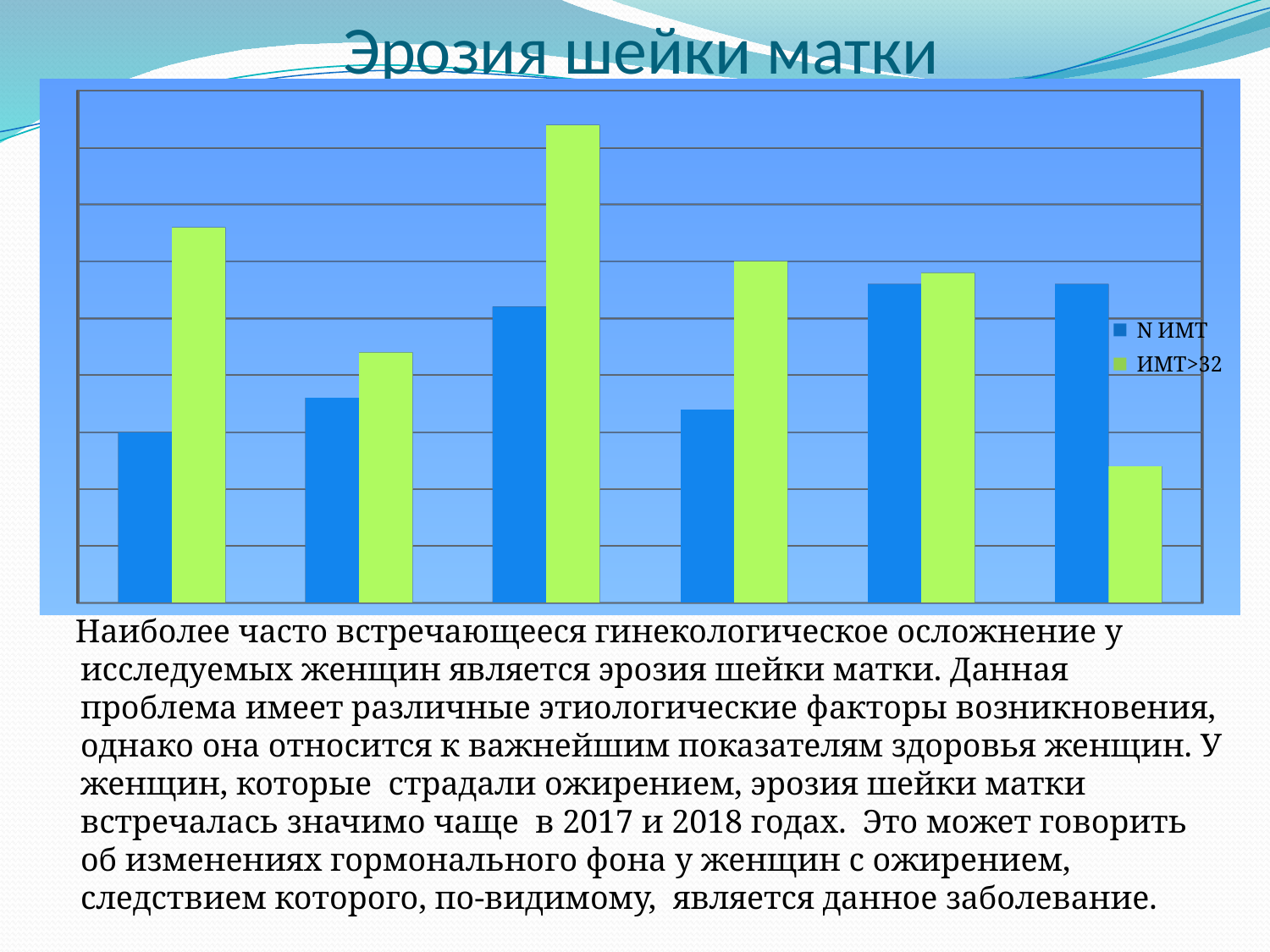
Which group of bars, counting from the left, has the tallest ИМТ>32 bar? the third In the rightmost group of bars, which series has the taller bar, N ИМТ or ИМТ>32? N ИМТ In the third group of bars from the left, which series has the taller bar? ИМТ>32 In how many of the bar groups is the ИМТ>32 bar taller than the N ИМТ bar? 5 Which group of bars, counting from the left, has the shortest N ИМТ bar? the first Which group of bars, counting from the left, has the shortest ИМТ>32 bar? the sixth Which colour represents the ИМТ>32 series in the chart? green How many groups of bars are plotted in the chart? 6 How many series does the chart legend list? 2 What kind of chart is shown on the slide? bar chart In the leftmost group of bars, which series has the taller bar, N ИМТ or ИМТ>32? ИМТ>32 What are the two series named in the chart legend? N ИМТ and ИМТ>32